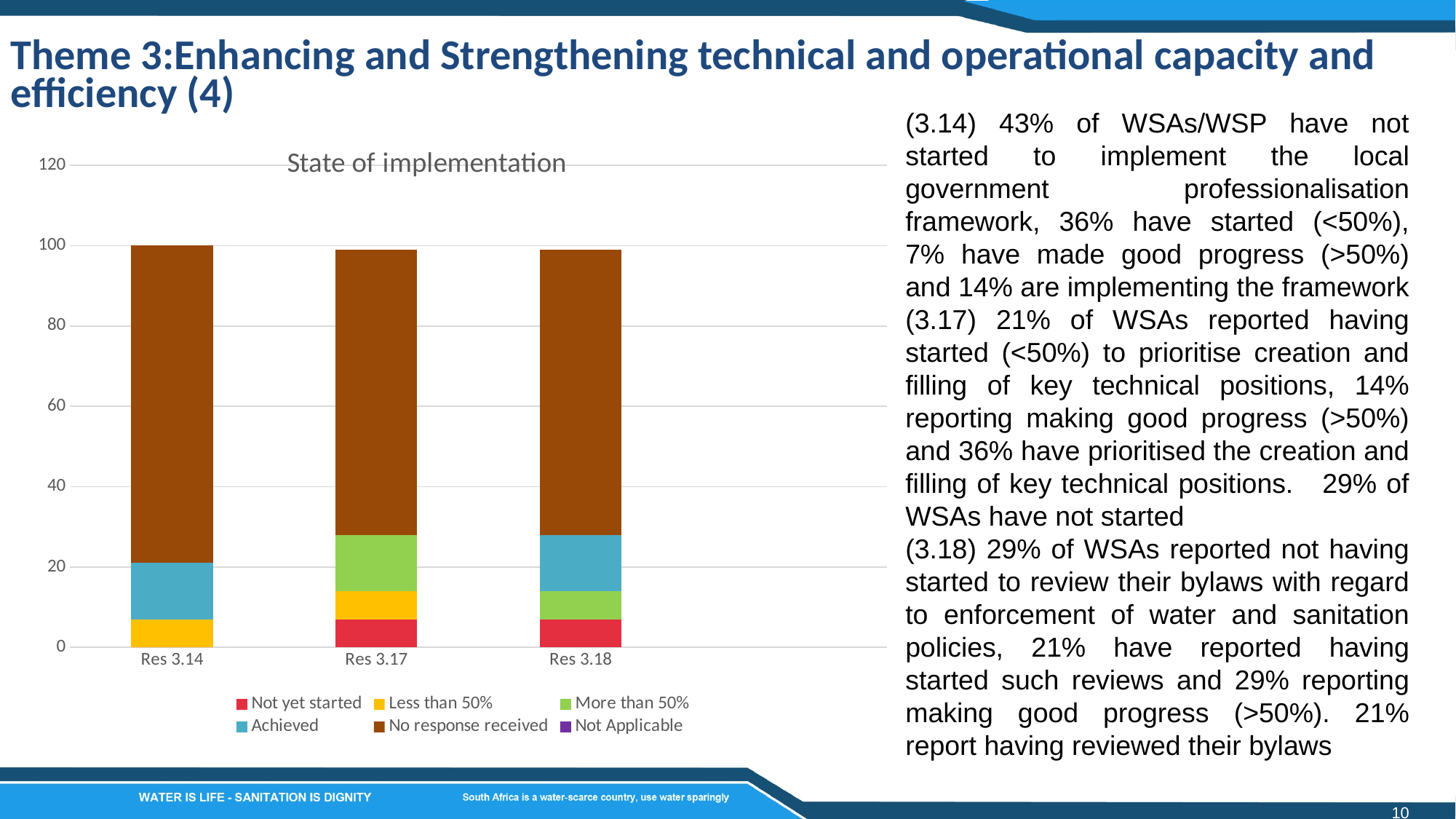
How many categories are shown on the x axis of the chart? 3 Is the 'More than 50%' segment larger for Res 3.17 or Res 3.18? Res 3.17 What is the total height of the stacked bar for Res 3.14? 100 Which category has the largest 'No response received' segment? Res 3.14 What colour represents 'No response received' in the chart? Brown What is the title of the chart? State of implementation What kind of chart is shown on the slide? Stacked bar chart Is the 'Not yet started' segment for Res 3.17 greater or less than 20? less How many categories show an 'Achieved' segment? 2 Is the top of the 'Achieved' segment for Res 3.14 greater or less than 40? less How many series does the chart legend list? 6 Which category has the smallest 'Not yet started' segment? Res 3.14